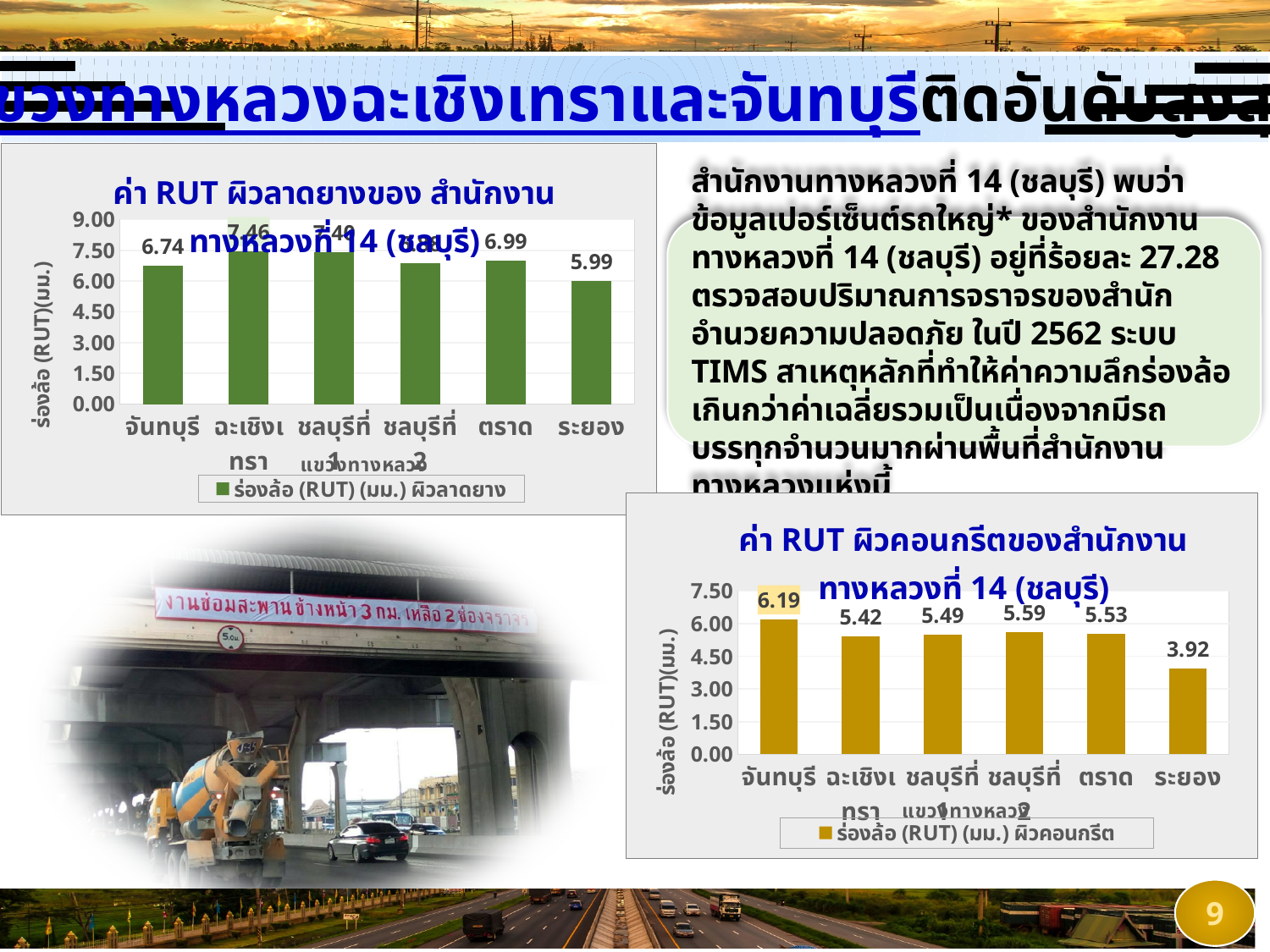
What kind of chart is the chart titled 'ค่า RUT ผิวลาดยางของ สำนักงานทางหลวงที่ 14 (ชลบุรี)' (top left)? bar chart In the chart titled 'ค่า RUT ผิวคอนกรีตของสำนักงานทางหลวงที่ 14 (ชลบุรี)' (bottom right), what is the difference between the values for จันทบุรี and ระยอง? 2.27 In the chart titled 'ค่า RUT ผิวลาดยางของ สำนักงานทางหลวงที่ 14 (ชลบุรี)' (top left), what is the value for ระยอง? 5.99 In the chart titled 'ค่า RUT ผิวคอนกรีตของสำนักงานทางหลวงที่ 14 (ชลบุรี)' (bottom right), what is the value for ระยอง? 3.92 In the chart titled 'ค่า RUT ผิวคอนกรีตของสำนักงานทางหลวงที่ 14 (ชลบุรี)' (bottom right), what is the value for จันทบุรี? 6.19 In the chart titled 'ค่า RUT ผิวลาดยางของ สำนักงานทางหลวงที่ 14 (ชลบุรี)' (top left), is the value for ตราด greater or less than 6.00? greater In the chart titled 'ค่า RUT ผิวคอนกรีตของสำนักงานทางหลวงที่ 14 (ชลบุรี)' (bottom right), which category has the highest value? จันทบุรี In the chart titled 'ค่า RUT ผิวลาดยางของ สำนักงานทางหลวงที่ 14 (ชลบุรี)' (top left), which category has the lowest value? ระยอง In the chart titled 'ค่า RUT ผิวคอนกรีตของสำนักงานทางหลวงที่ 14 (ชลบุรี)' (bottom right), which category has the lowest value? ระยอง In the chart titled 'ค่า RUT ผิวลาดยางของ สำนักงานทางหลวงที่ 14 (ชลบุรี)' (top left), what is the value for จันทบุรี? 6.74 In the chart titled 'ค่า RUT ผิวคอนกรีตของสำนักงานทางหลวงที่ 14 (ชลบุรี)' (bottom right), how many categories are plotted? 6 In the chart titled 'ค่า RUT ผิวคอนกรีตของสำนักงานทางหลวงที่ 14 (ชลบุรี)' (bottom right), which is larger, the value for ชลบุรีที่ 2 or the value for ฉะเชิงเทรา? ชลบุรีที่ 2